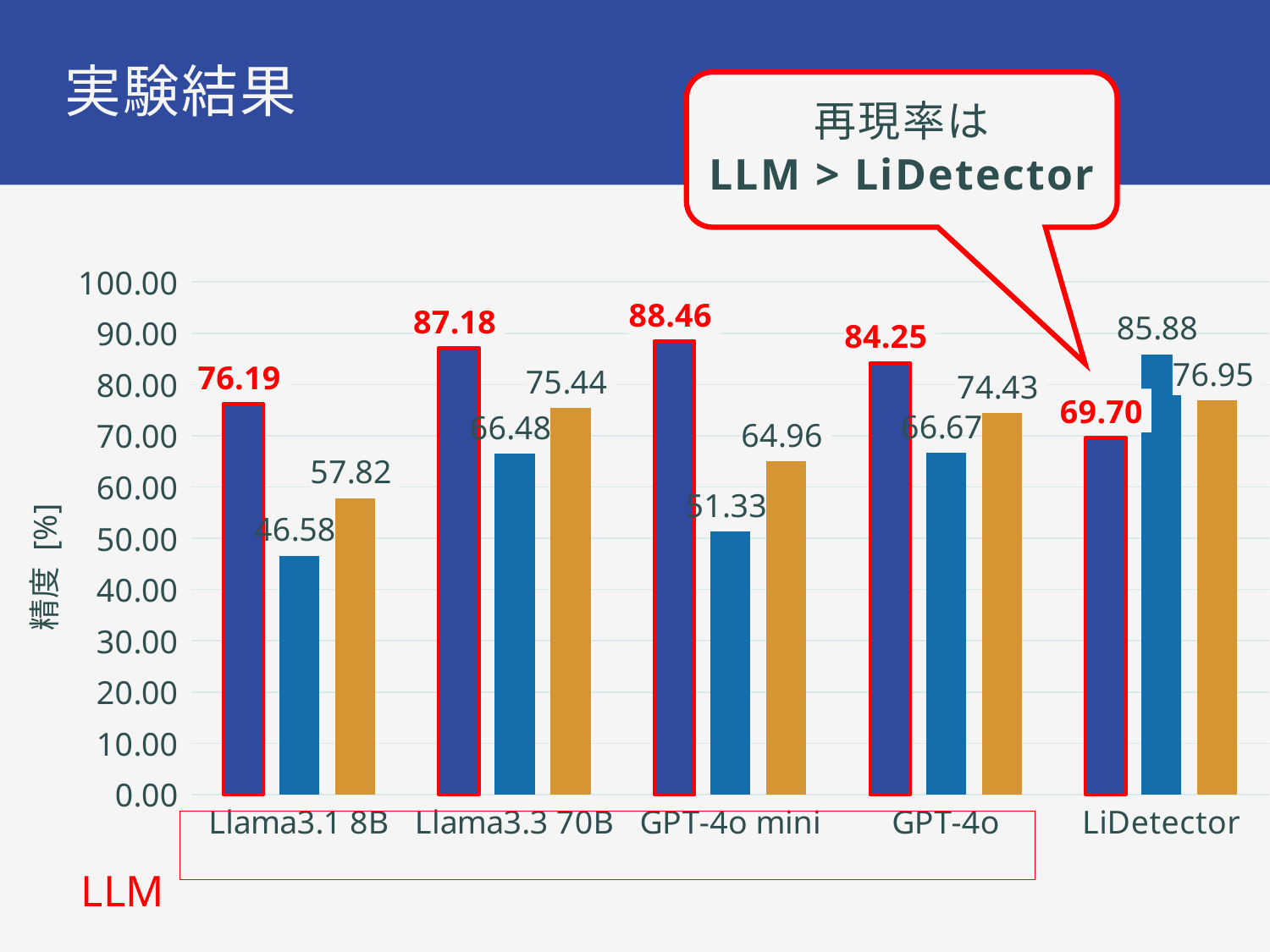
Which category has the lowest dark blue (red-outlined) bar? LiDetector What is the difference between the dark blue bar for GPT-4o mini (88.46) and the dark blue bar for LiDetector (69.70)? 18.76 What is the value of the orange bar for Llama3.3 70B? 75.44 What is the value of the light blue bar for Llama3.1 8B? 46.58 Which category has the highest dark blue (red-outlined) bar? GPT-4o mini What is the label of the y axis of the chart? 精度 [%] What is the value of the dark blue (red-outlined) bar for GPT-4o mini? 88.46 Which category has the lowest light blue bar? Llama3.1 8B What kind of chart is shown on the slide? bar chart How many categories are shown on the x axis of the chart? 5 Which is larger: the orange bar for GPT-4o or the orange bar for GPT-4o mini? GPT-4o What is the value of the light blue bar for LiDetector? 85.88